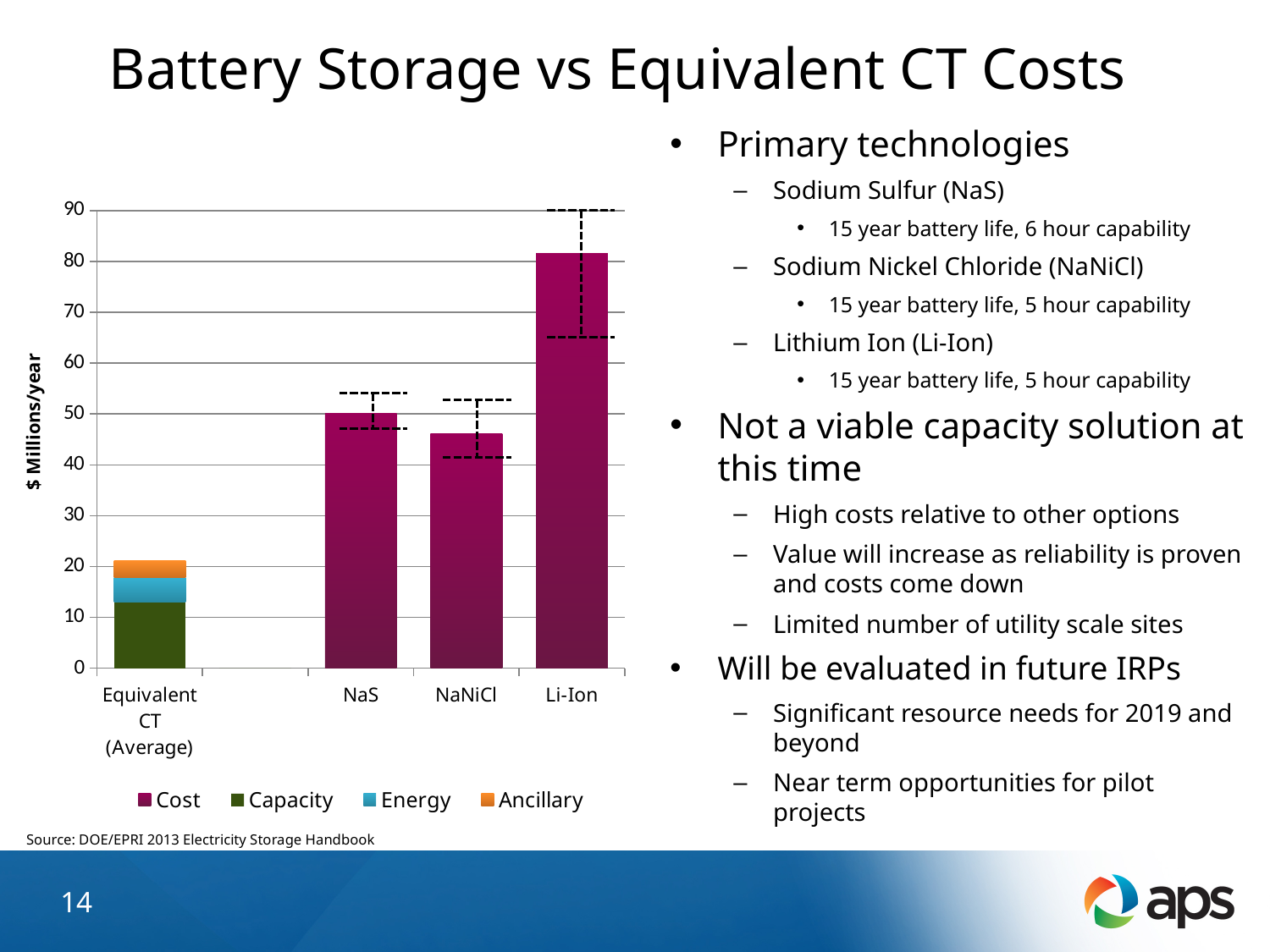
Is the value for NaNiCl greater or less than 50? less Is the value for NaS greater or less than 40? greater Which category has the highest total bar in the chart? Li-Ion Which is larger, the bar for Li-Ion or the bar for NaS? Li-Ion Which category has the lowest total bar in the chart? Equivalent CT (Average) What kind of chart is shown on the slide? Stacked bar chart Is the value for Li-Ion greater or less than 70? greater How many series does the chart legend list? 4 What is the label on the vertical axis of the chart? $ Millions/year How many categories are shown on the x axis of the chart? 4 Which legend entry is shown in orange? Ancillary